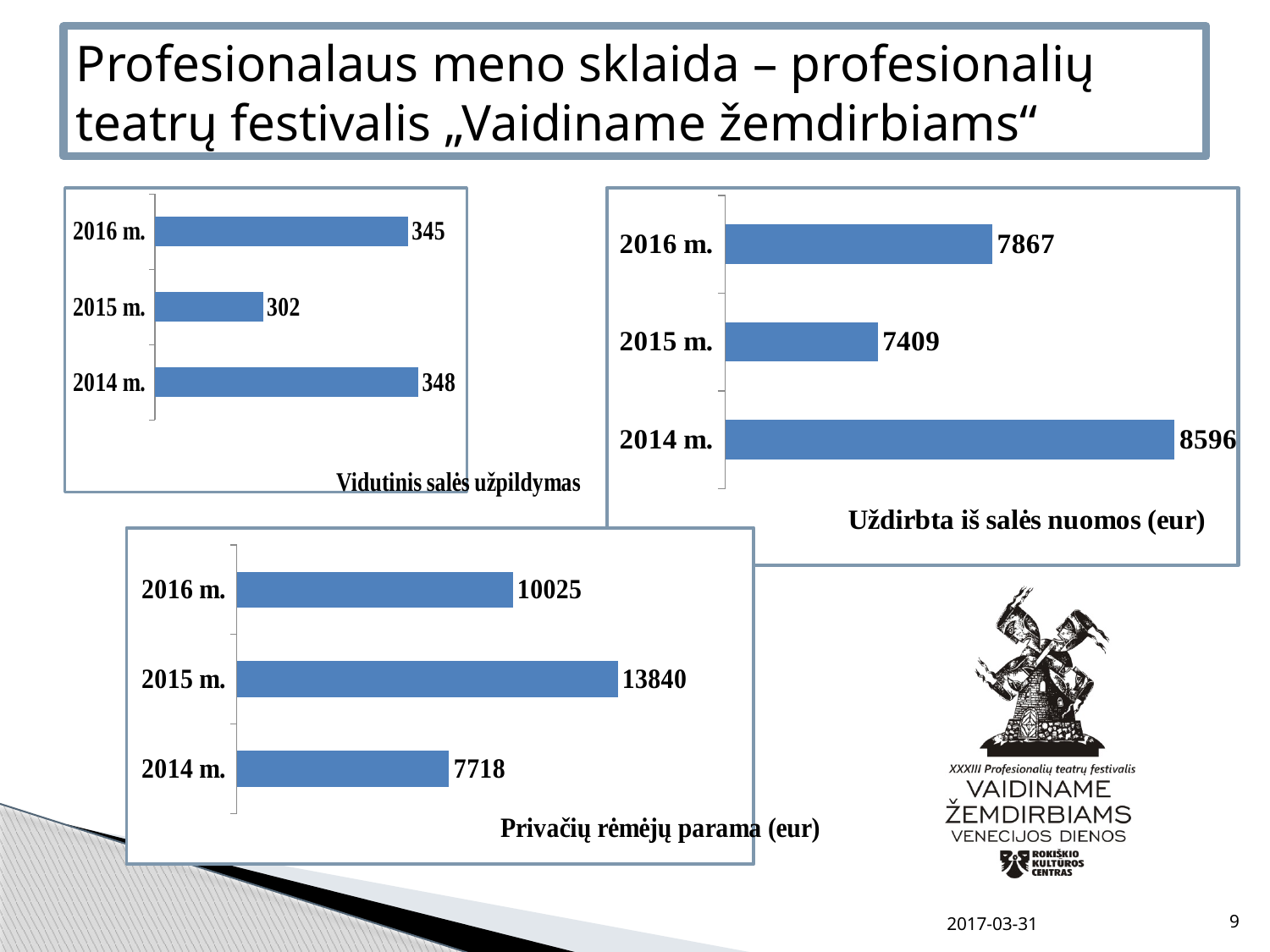
What kind of chart is the chart titled "Vidutinis salės užpildymas"? Bar chart In the chart titled "Uždirbta iš salės nuomos (eur)", what is the value for 2016 m.? 7867 In the chart titled "Privačių rėmėjų parama (eur)", which year has the highest value? 2015 m. In the chart titled "Uždirbta iš salės nuomos (eur)", which year has the lowest value? 2015 m. In the chart titled "Vidutinis salės užpildymas", what is the value for 2015 m.? 302 In the chart titled "Privačių rėmėjų parama (eur)", which is larger, the value for 2016 m. or 2014 m.? 2016 m. In the chart titled "Privačių rėmėjų parama (eur)", what is the value for 2015 m.? 13840 In the chart titled "Vidutinis salės užpildymas", what is the difference between the values for 2016 m. and 2015 m.? 43 In the chart titled "Privačių rėmėjų parama (eur)", what is the difference between the values for 2015 m. and 2014 m.? 6122 In the chart titled "Uždirbta iš salės nuomos (eur)", what is the difference between the values for 2014 m. and 2016 m.? 729 In the chart titled "Vidutinis salės užpildymas", which year has the highest value? 2014 m. How many categories does the chart titled "Uždirbta iš salės nuomos (eur)" show? 3